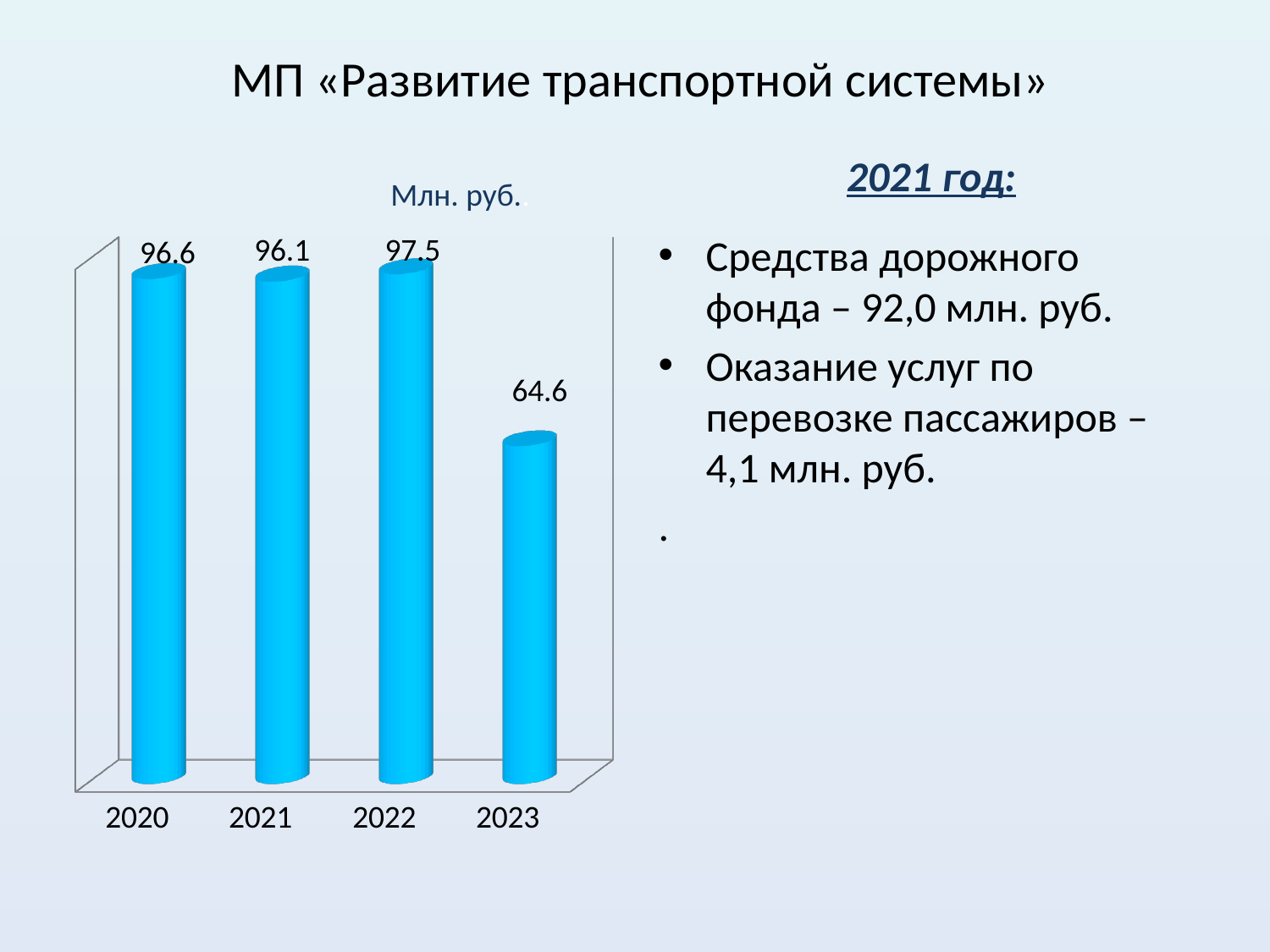
What is the difference between the values for 2022 and 2023? 32.9 Which year has the highest value? 2022 Which is larger, the value for 2020 or the value for 2023? 2020 What kind of chart is shown on the slide? bar chart What is the value for 2021? 96.1 What unit label is shown above the chart? Млн. руб. What is the value for 2020? 96.6 What is the value for 2022? 97.5 What is the value for 2023? 64.6 What is the difference between the values for 2020 and 2021? 0.5 How many years are shown on the chart? 4 Which year has the lowest value? 2023